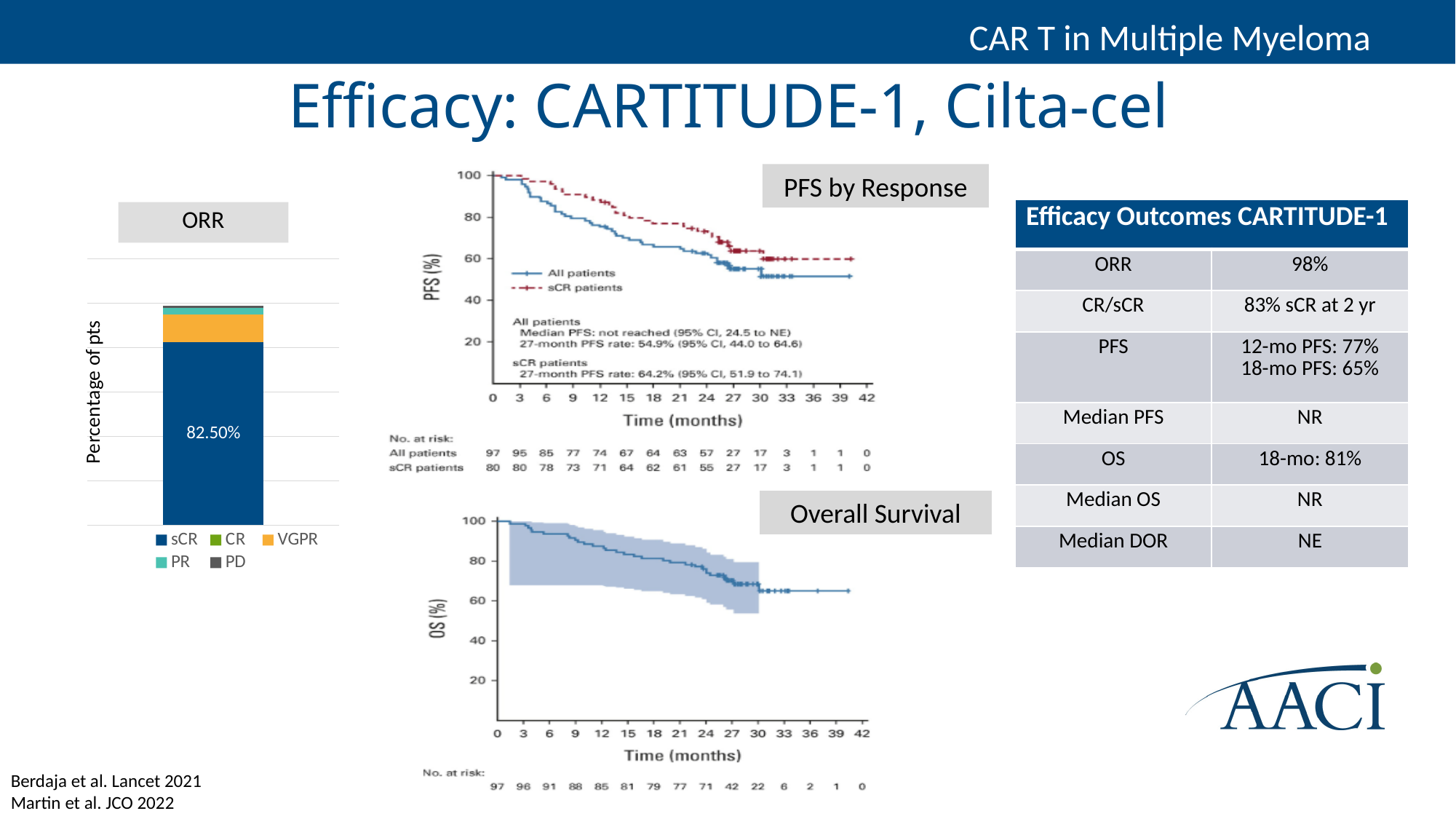
In the PFS by Response chart, what is the 27-month PFS rate for sCR patients? 64.2% In the ORR chart, which response category makes up the largest segment of the bar? sCR How many series does the legend of the PFS by Response chart list? 2 In the ORR chart, which colour represents VGPR? orange In the PFS by Response chart, what is the 27-month PFS rate for all patients? 54.9% What kind of chart is the ORR chart on the left of the slide? bar chart In the Overall Survival chart, do the OS values rise or fall along the time axis? fall In the PFS by Response chart, how many sCR patients were at risk at time 0? 80 In the PFS by Response chart, which group has the higher PFS at 24 months, all patients or sCR patients? sCR patients How many series does the legend of the ORR chart list? 5 In the Overall Survival chart, is the OS value at 12 months greater or less than 80? greater In the ORR chart, what percentage of patients achieved sCR? 82.50%